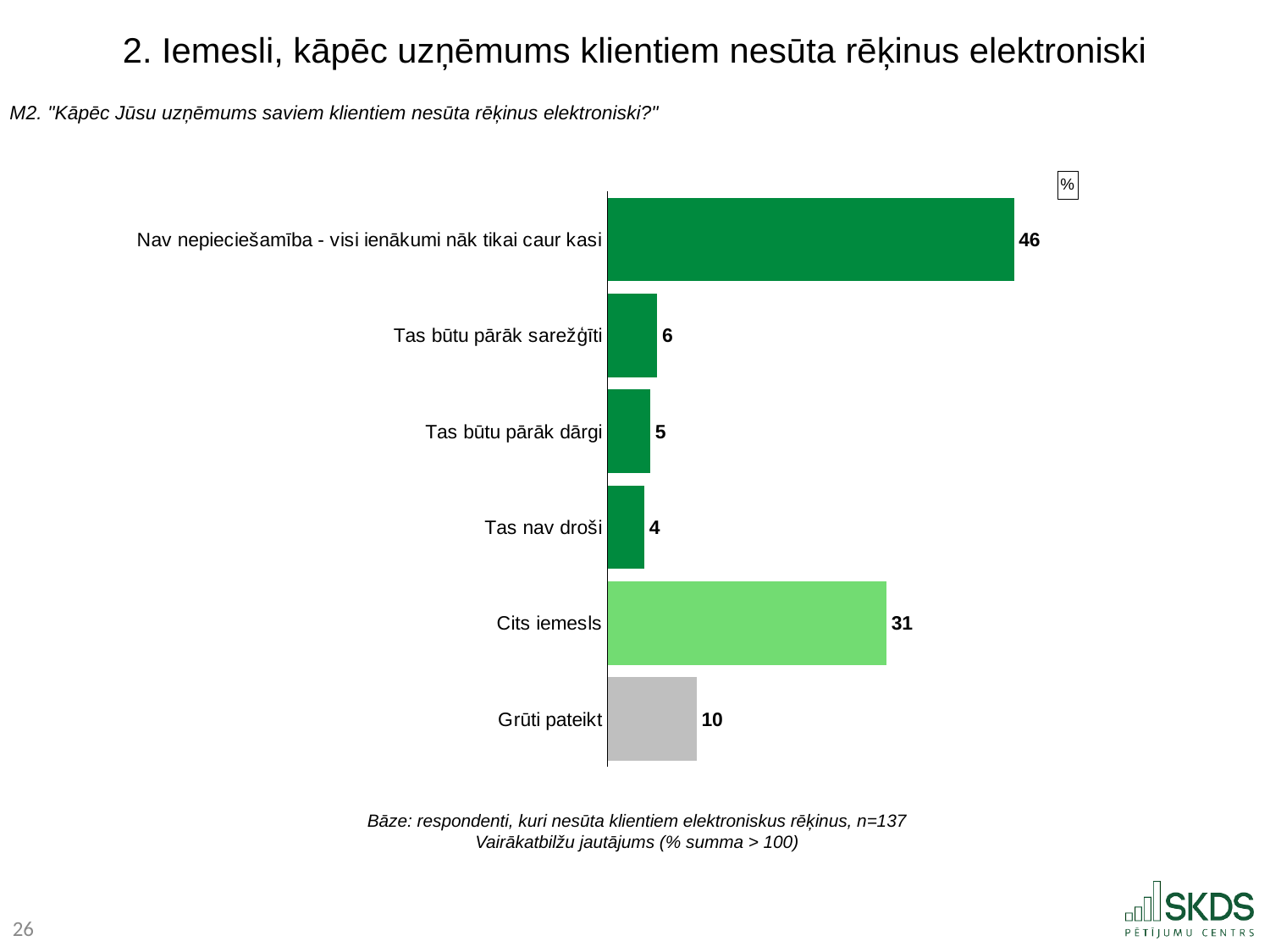
What is the difference between the values for "Tas būtu pārāk sarežģīti" and "Tas nav droši"? 2 What is the value for "Grūti pateikt"? 10 How many categories are shown in the chart? 6 Which category has the lowest value? Tas nav droši What is the difference between the values for "Nav nepieciešamība - visi ienākumi nāk tikai caur kasi" and "Cits iemesls"? 15 What is the value for "Cits iemesls"? 31 What is the value for "Tas būtu pārāk dārgi"? 5 What is the value for "Nav nepieciešamība - visi ienākumi nāk tikai caur kasi"? 46 Which category has the highest value? Nav nepieciešamība - visi ienākumi nāk tikai caur kasi Which is larger, the value for "Tas būtu pārāk sarežģīti" or the value for "Grūti pateikt"? Grūti pateikt What kind of chart is shown on the slide? Bar chart What is the sample size (n) stated in the base note below the chart? n=137